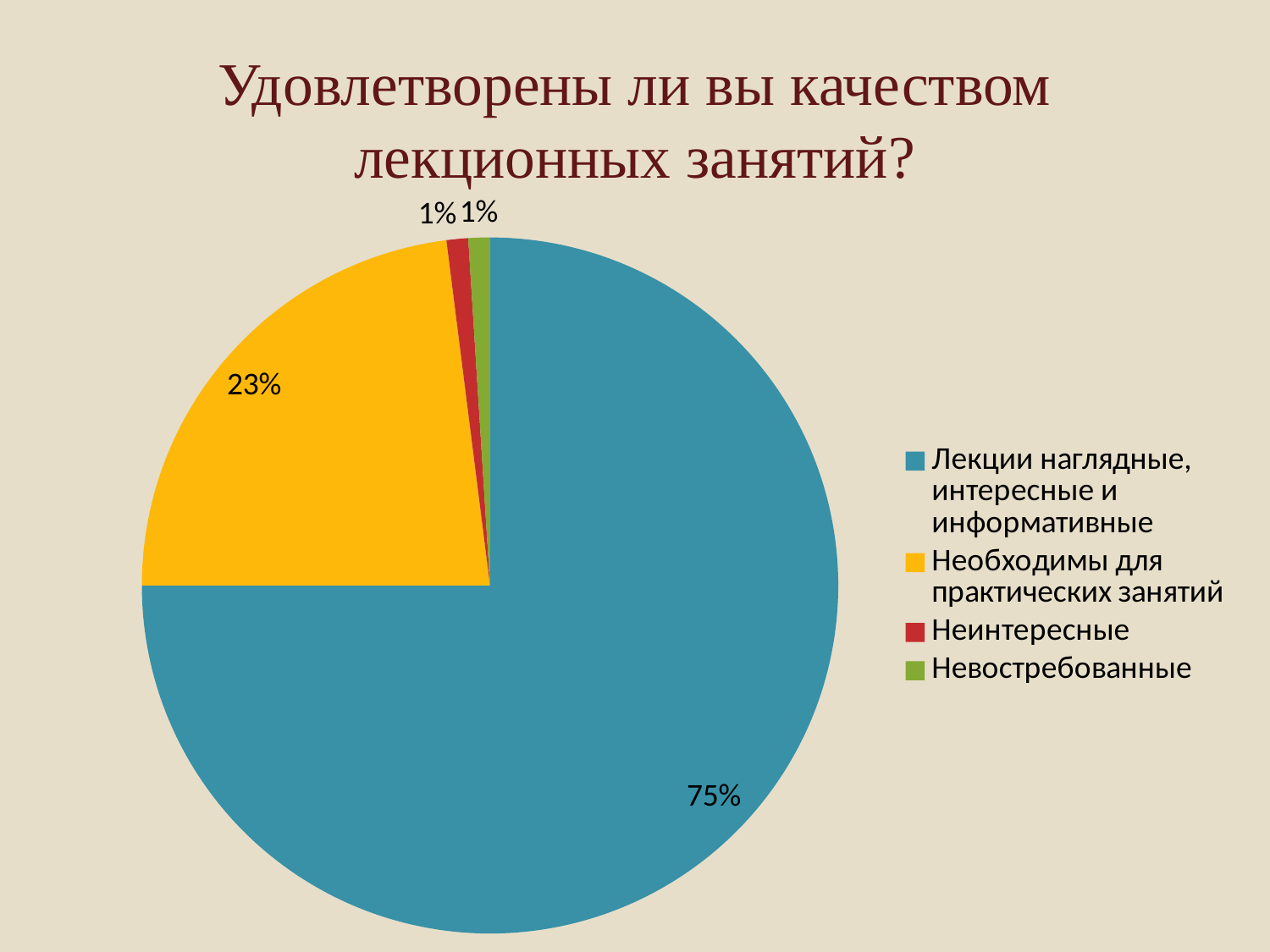
What is the difference between the shares for "Лекции наглядные, интересные и информативные" and "Необходимы для практических занятий"? 52% Which is larger: the share for "Необходимы для практических занятий" or the share for "Неинтересные"? Необходимы для практических занятий What share of the pie does "Необходимы для практических занятий" have? 23% What kind of chart is shown on the slide? pie chart What share of the pie does "Невостребованные" have? 1% How many categories does the legend list? 4 What share of the pie does "Лекции наглядные, интересные и информативные" have? 75% What is the combined share of "Неинтересные" and "Невостребованные"? 2% Which category has the largest slice of the pie? Лекции наглядные, интересные и информативные What is the title of the chart? Удовлетворены ли вы качеством лекционных занятий? What colour is the slice for "Необходимы для практических занятий"? yellow